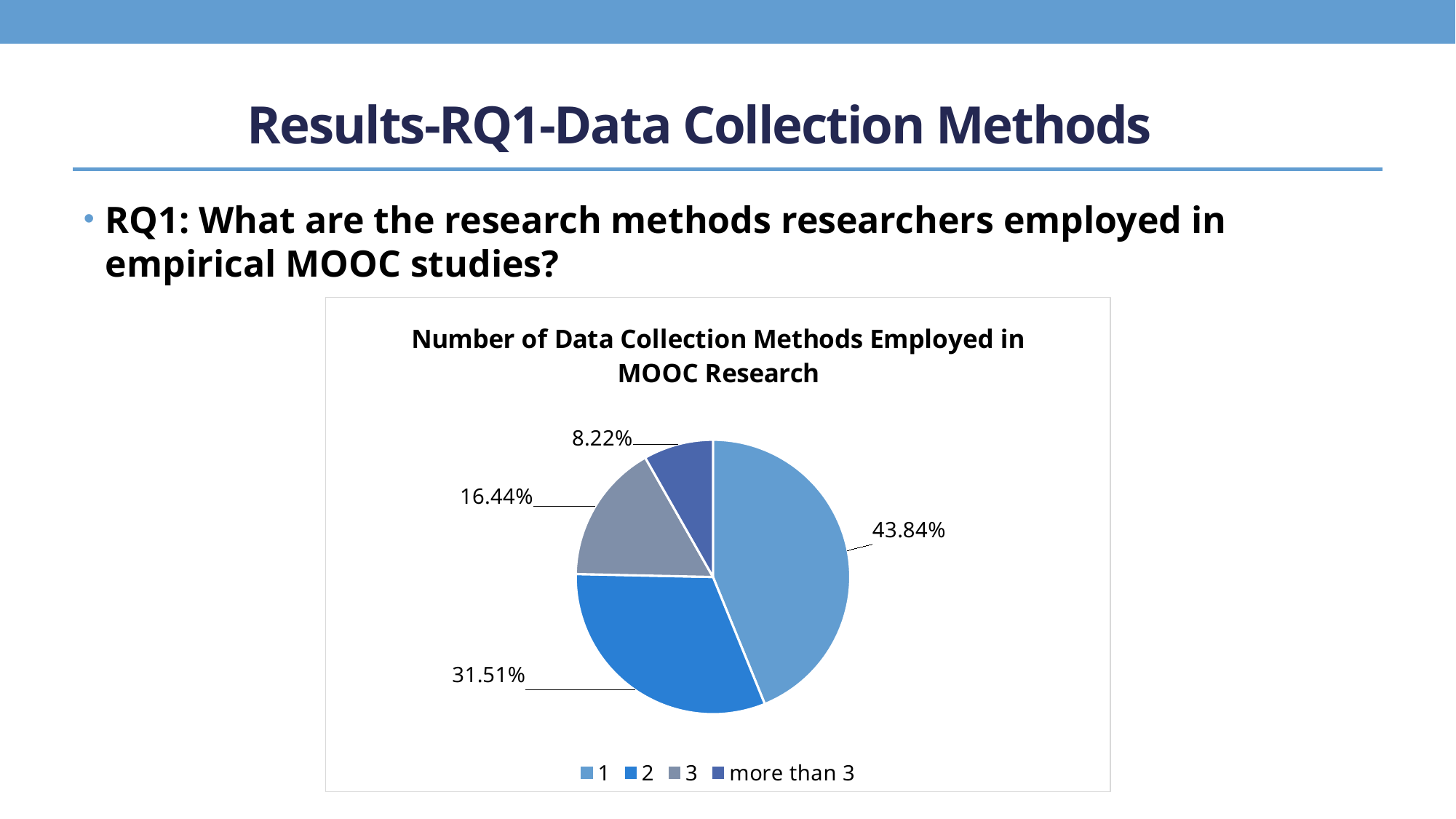
Which category has the largest slice of the pie? 1 What is the difference in percentage points between the slices for '3' and 'more than 3'? 8.22 What share of the pie is labelled for the category '2'? 31.51% What share of the pie is labelled for the category '3'? 16.44% Which slice is larger, '3' or 'more than 3'? 3 How many categories does the legend list? 4 What is the title of the chart? Number of Data Collection Methods Employed in MOOC Research What is the difference in percentage points between the slices for '1' and '2'? 12.33 What share of the pie is labelled for the category 'more than 3'? 8.22% What kind of chart is shown on the slide? pie chart Which category has the smallest slice of the pie? more than 3